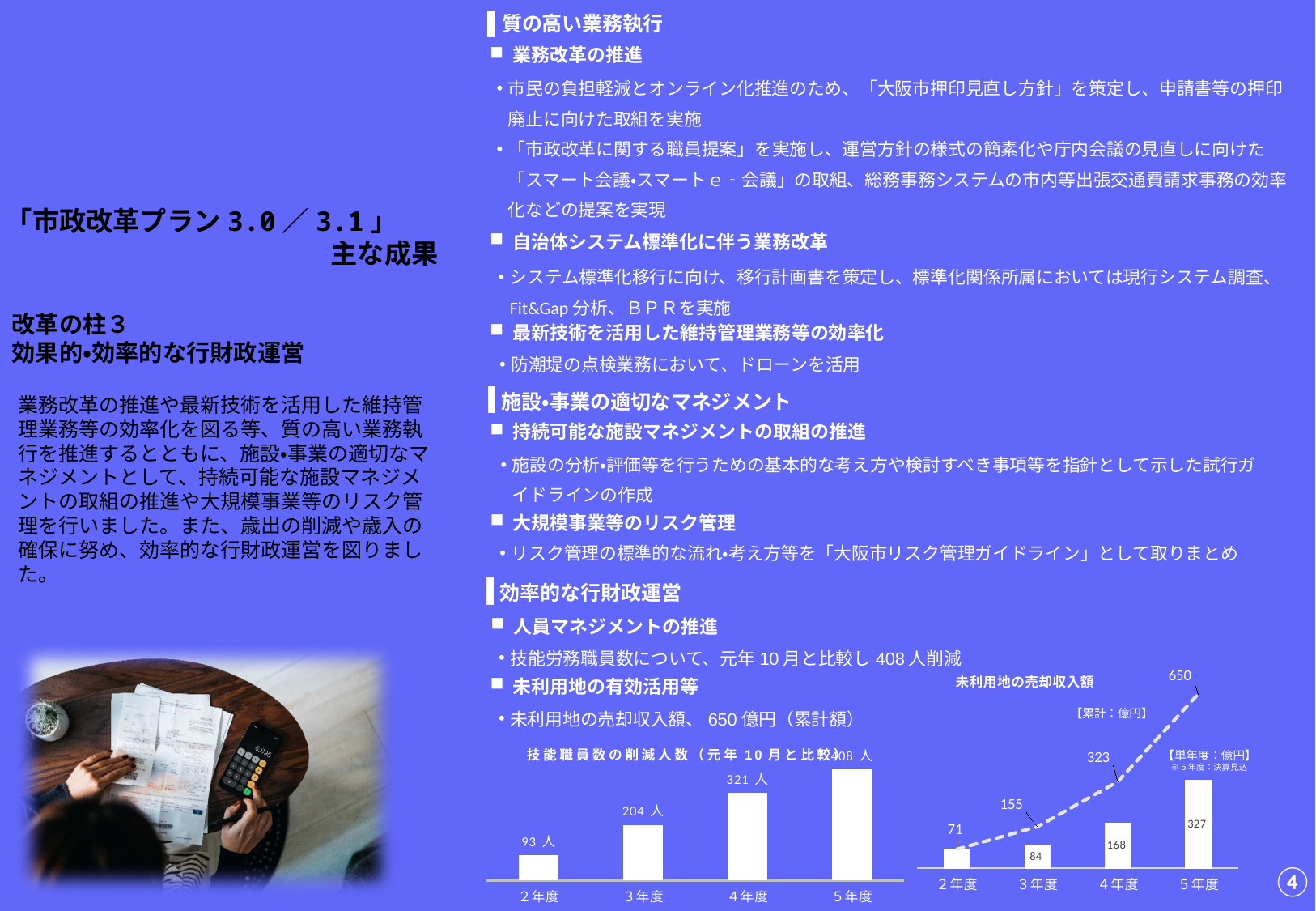
In the chart titled 未利用地の売却収入額, what is the difference between the cumulative values for 5年度 and 4年度? 327 In the chart titled 未利用地の売却収入額, which is larger, the single-year value for 4年度 or for 3年度? 4年度 In the chart titled 技能職員数の削減人数（元年10月と比較）, which year has the highest value? 5年度 In the chart titled 未利用地の売却収入額, what unit is given for the values? 億円 In the chart titled 未利用地の売却収入額, what is the single-year (単年度) value for 5年度? 327 In the chart titled 技能職員数の削減人数（元年10月と比較）, which year has the lowest value? 2年度 In the chart titled 未利用地の売却収入額, what is the cumulative (累計) value for 4年度? 323 In the chart titled 技能職員数の削減人数（元年10月と比較）, how many years are plotted? 4 What kind of chart is the one titled 技能職員数の削減人数（元年10月と比較）? bar chart In the chart titled 技能職員数の削減人数（元年10月と比較）, do the values rise or fall from 2年度 to 5年度? rise In the chart titled 技能職員数の削減人数（元年10月と比較）, what is the difference between the values for 5年度 and 2年度? 315 人 In the chart titled 技能職員数の削減人数（元年10月と比較）, what is the value for 4年度? 321 人